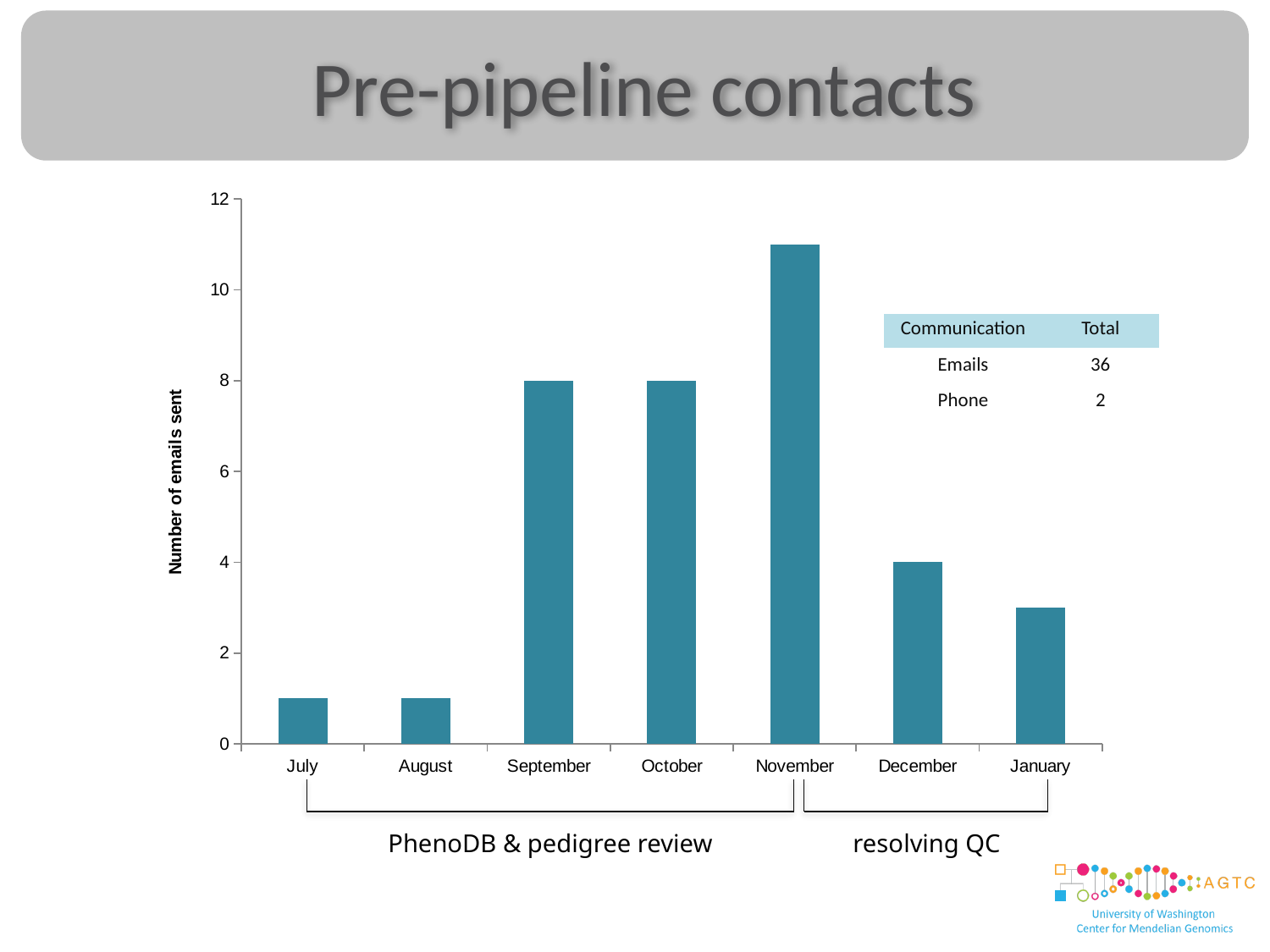
What is the difference between the number of emails sent in September and in December? 4 What is the number of emails sent in September? 8 How many months are shown on the x axis of the chart? 7 Is the value for January greater or less than 4? less Which is larger, the value for November or the value for December? November What kind of chart is shown on the slide? bar chart Is the value for July greater or less than 2? less What is the label on the y axis of the chart? Number of emails sent Which month has the highest number of emails sent? November What is the number of emails sent in October? 8 What is the number of emails sent in December? 4 Is the value for November greater or less than 10? greater